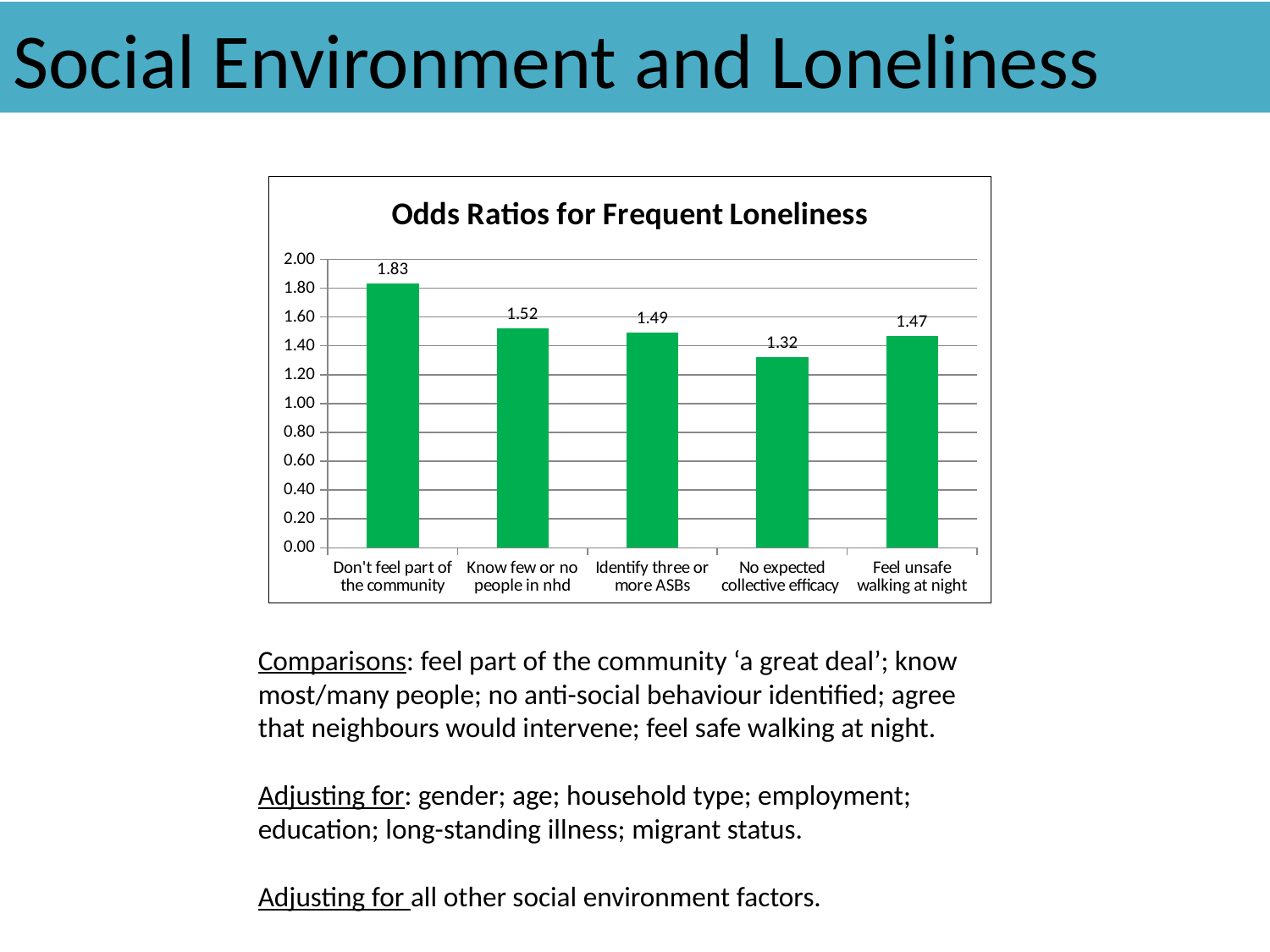
What kind of chart is shown on the slide? Bar chart Which category has the highest odds ratio? Don't feel part of the community What is the title of the chart? Odds Ratios for Frequent Loneliness What is the difference between the odds ratios for 'Know few or no people in nhd' and 'Identify three or more ASBs'? 0.03 What is the difference between the odds ratios for 'Don't feel part of the community' and 'No expected collective efficacy'? 0.51 What is the odds ratio for 'Don't feel part of the community'? 1.83 How many categories are shown in the chart? 5 What is the odds ratio for 'No expected collective efficacy'? 1.32 Which category has the lowest odds ratio? No expected collective efficacy Which has a larger odds ratio: 'Know few or no people in nhd' or 'No expected collective efficacy'? Know few or no people in nhd Is the odds ratio for 'Identify three or more ASBs' greater or less than 1.00? greater What is the odds ratio for 'Feel unsafe walking at night'? 1.47